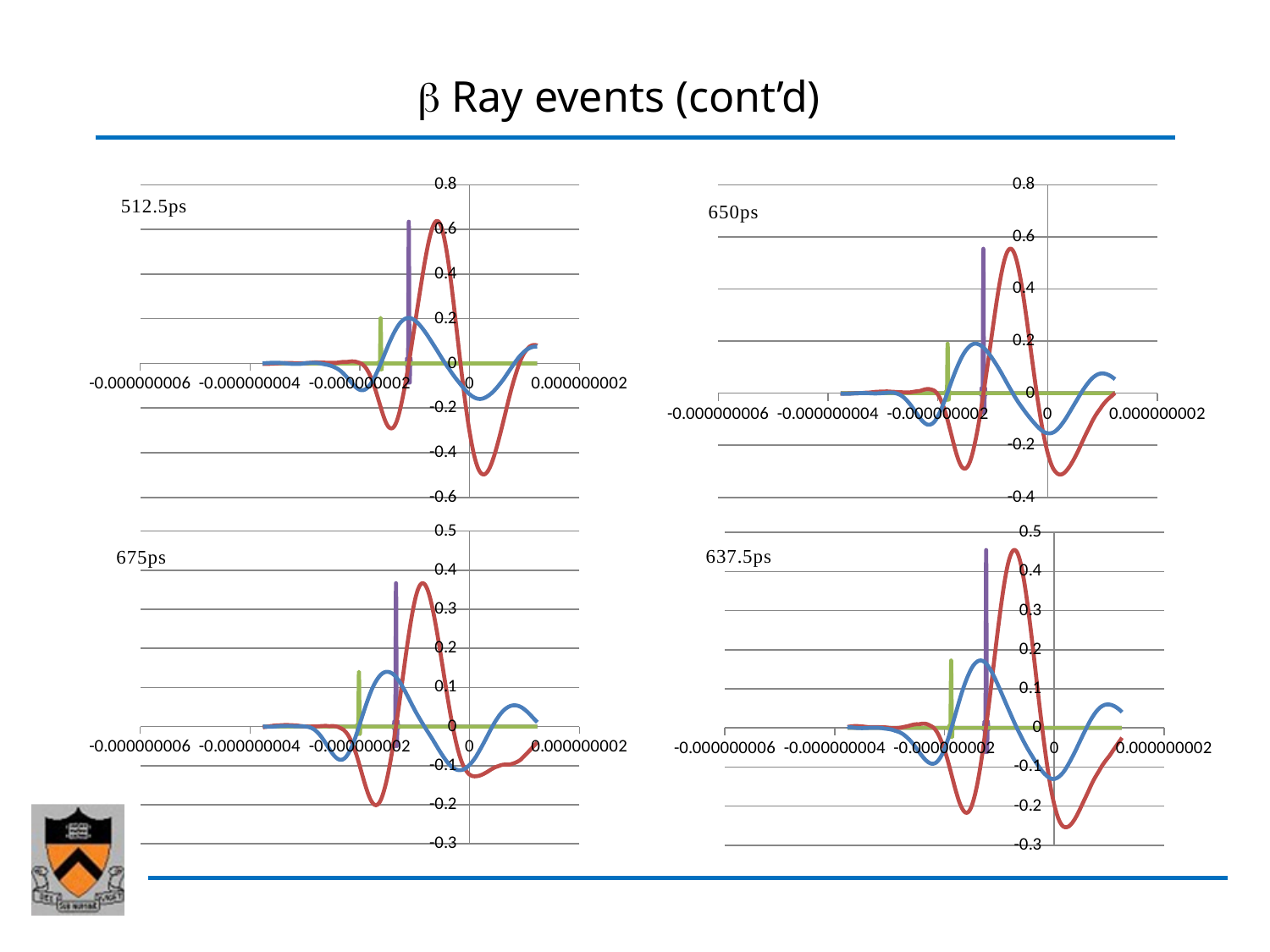
In the 675ps chart, is the peak of the red curve greater or less than 0.3? greater In the 512.5ps chart, is the peak of the red curve greater or less than 0.4? greater In the 512.5ps chart, what is the highest value shown on the vertical axis? 0.8 What kind of chart is the 512.5ps chart? line chart In the 650ps chart, is the minimum of the red curve greater or less than -0.2? less How many charts are shown on the slide? 4 In the 650ps chart, which curve reaches a higher peak, the red curve or the blue curve? red curve In the 512.5ps chart, what is the lowest value shown on the vertical axis? -0.6